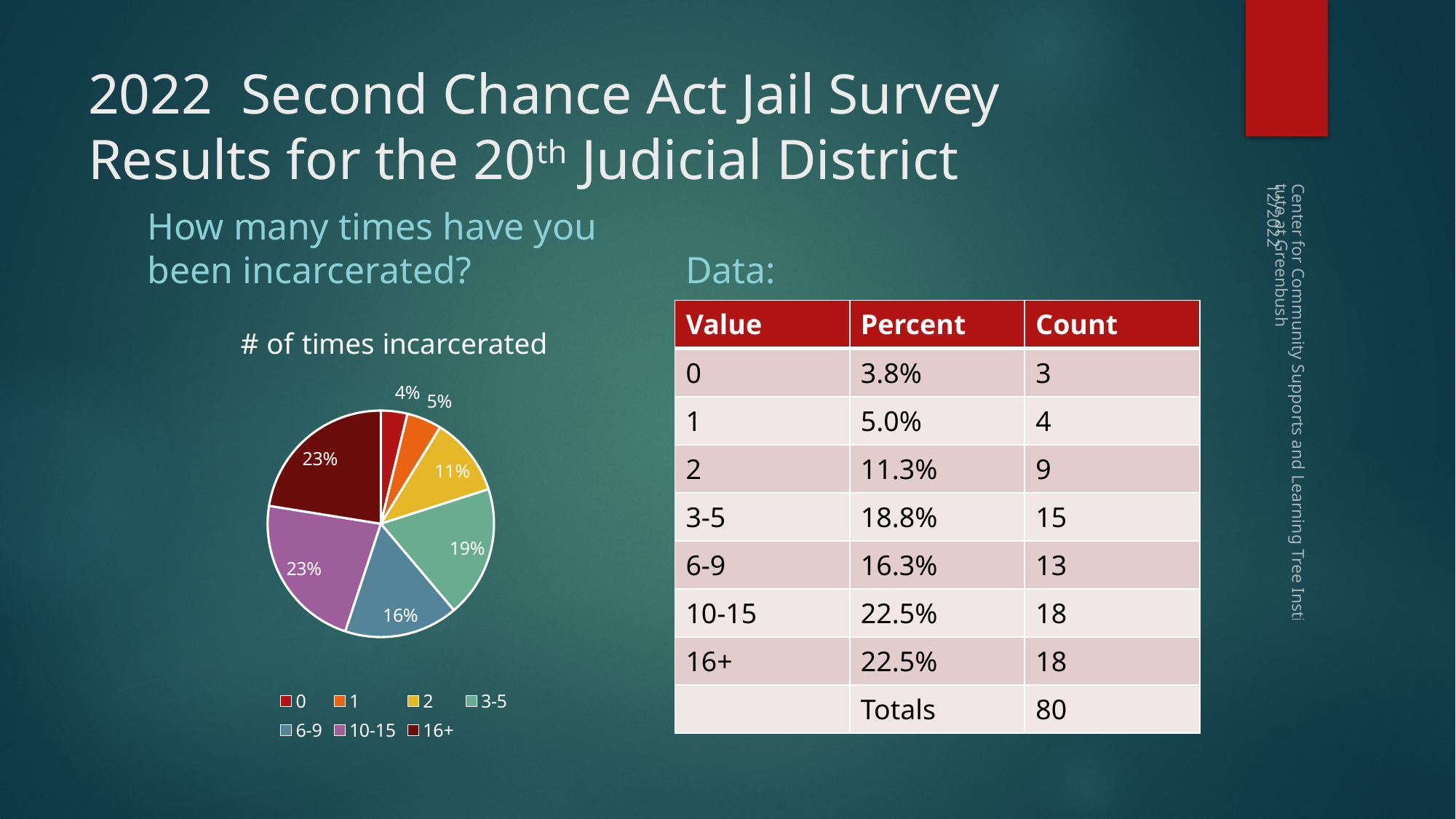
What share of the pie does the "1" category have? 5% How many slices does the pie chart have? 7 What type of chart is shown on the slide? pie chart What share of the pie does the "2" category have? 11% What is the title of the chart? # of times incarcerated How many entries does the chart legend list? 7 Which category has the smallest slice of the pie? 0 What share of the pie does the "10-15" category have? 23% What is the difference in percentage points between the "3-5" slice and the "6-9" slice? 3 Which slice is larger, "3-5" or "6-9"? 3-5